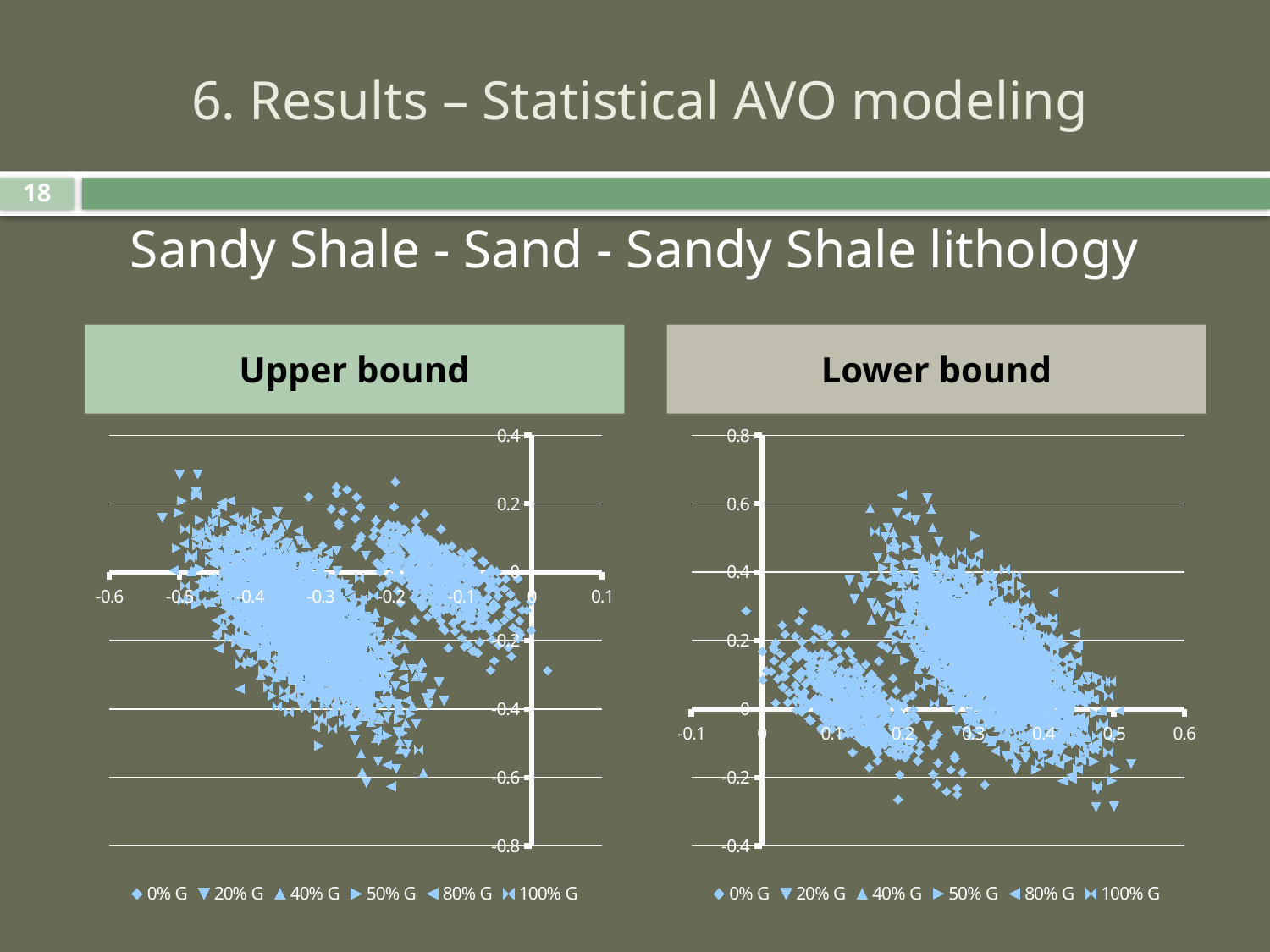
In the Upper bound chart, what is the first series listed in the legend? 0% G In the Lower bound chart, what is the last series listed in the legend? 100% G What is the lowest value shown on the y-axis of the Upper bound chart? -0.8 How many charts are shown on the slide? 2 What is the highest value shown on the x-axis of the Lower bound chart? 0.6 What is the highest value shown on the y-axis of the Lower bound chart? 0.8 In the Upper bound chart, do the plotted points generally rise or fall as the x-axis value increases? fall How many series does the legend of the Upper bound chart list? 6 How many series does the legend of the Lower bound chart list? 6 What kind of chart is the Upper bound chart? scatter chart What kind of chart is the Lower bound chart? scatter chart In the Lower bound chart, do the plotted points generally rise or fall as the x-axis value increases? fall